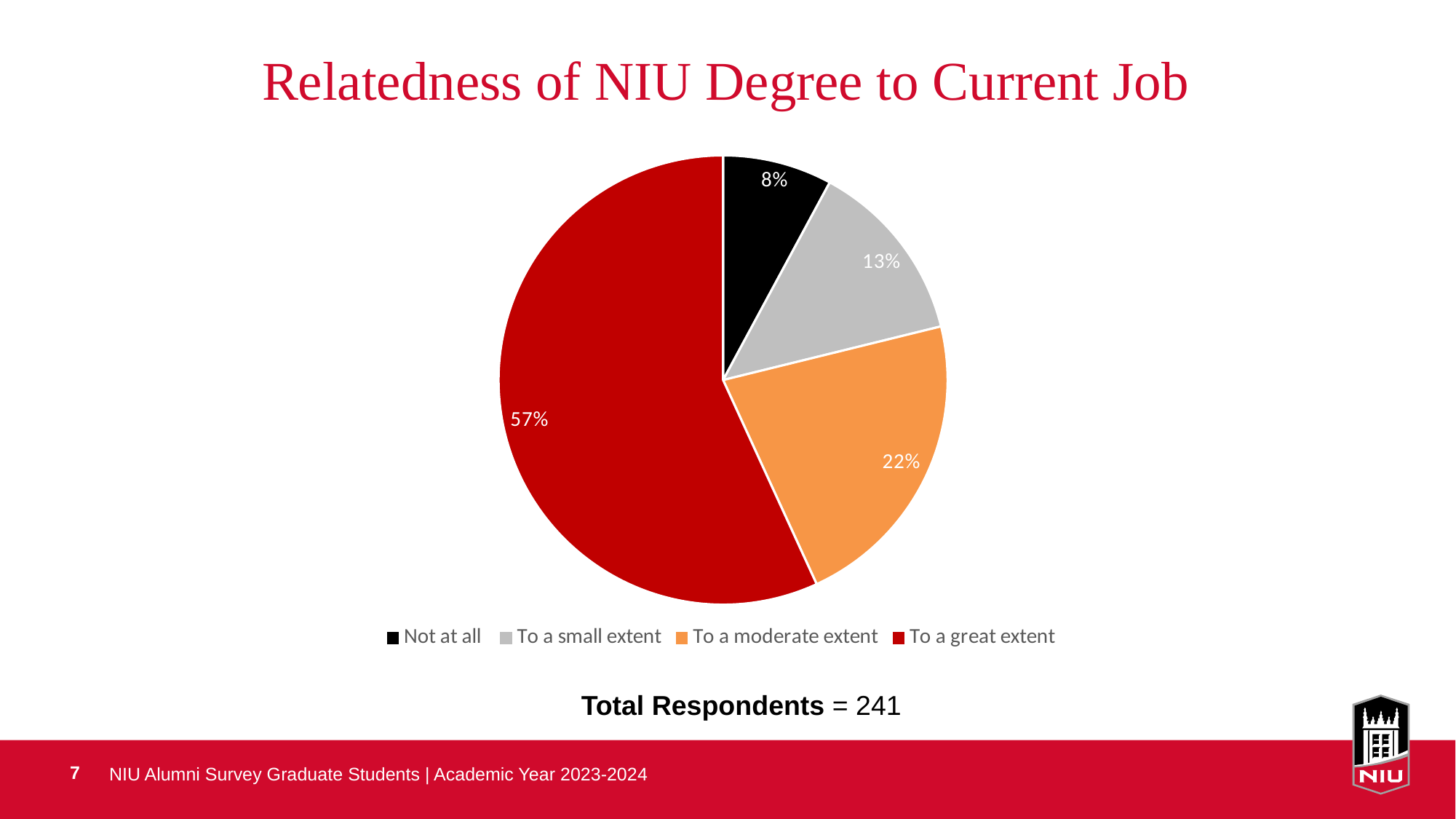
What percentage of respondents answered 'To a small extent'? 13% What kind of chart is shown on the slide? pie chart What percentage of respondents said their NIU degree relates to their current job 'To a great extent'? 57% Which is larger, the share for 'To a small extent' or the share for 'To a moderate extent'? To a moderate extent Which category has the largest share of the pie? To a great extent What percentage of respondents answered 'To a moderate extent'? 22% How many total respondents are reported on the slide? 241 What colour is the 'To a great extent' slice? red What is the difference in percentage points between 'To a great extent' and 'To a moderate extent'? 35 How many categories does the pie chart show? 4 Which category has the smallest share of the pie? Not at all What percentage of respondents answered 'Not at all'? 8%